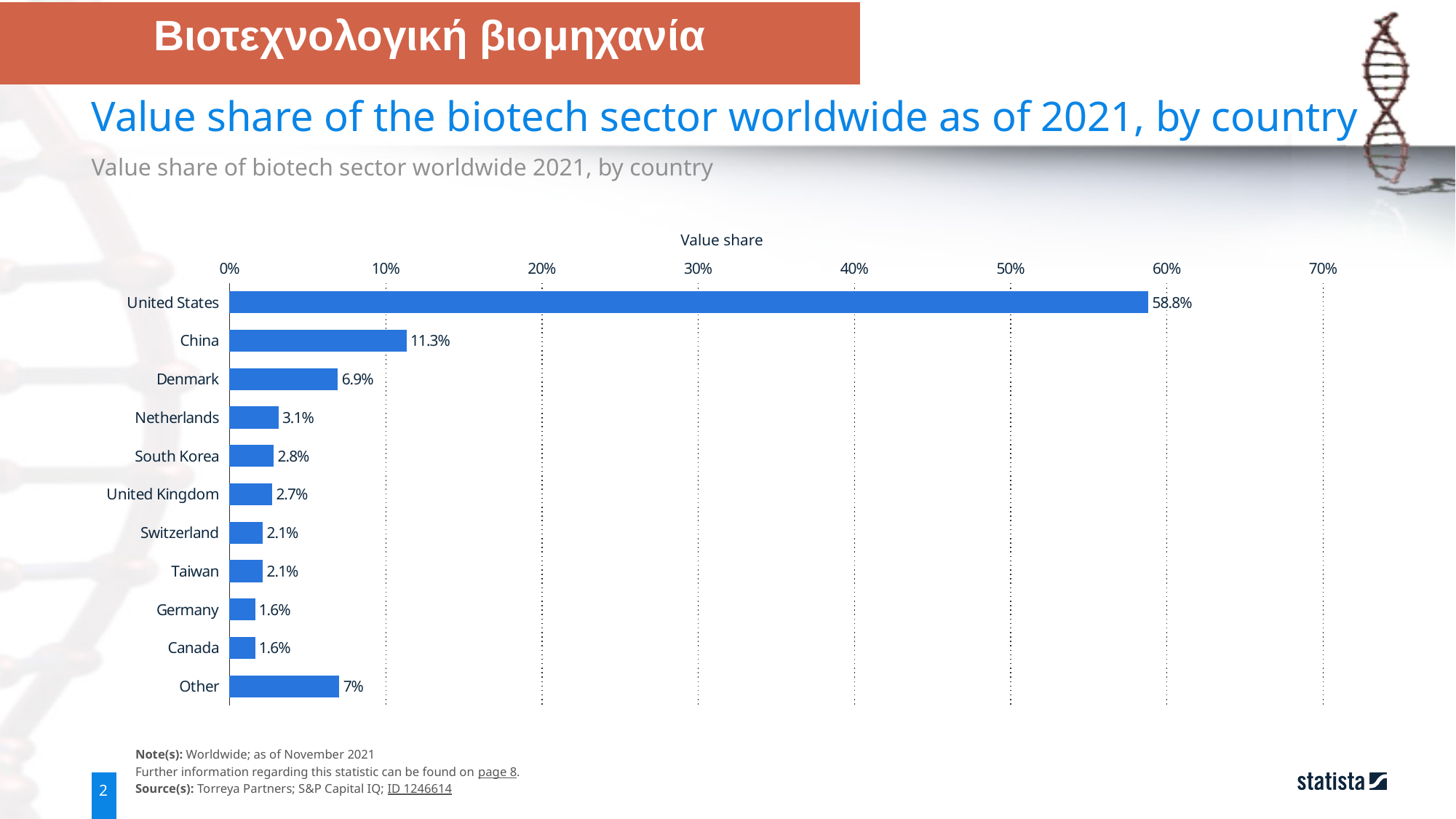
What is the difference in value share between South Korea and the United Kingdom? 0.1% Which has a larger value share, Denmark or Other? Other What is the value share for the United States? 58.8% What kind of chart is shown on the slide? Bar chart What is the value share for the Netherlands? 3.1% What is the title of the chart's value axis? Value share Which country has the highest value share? United States What is the value share for China? 11.3% How many categories are shown on the chart? 11 What is the value share for Denmark? 6.9% Is the value share for China greater or less than 10%? greater What is the difference in value share between the United States and China? 47.5%